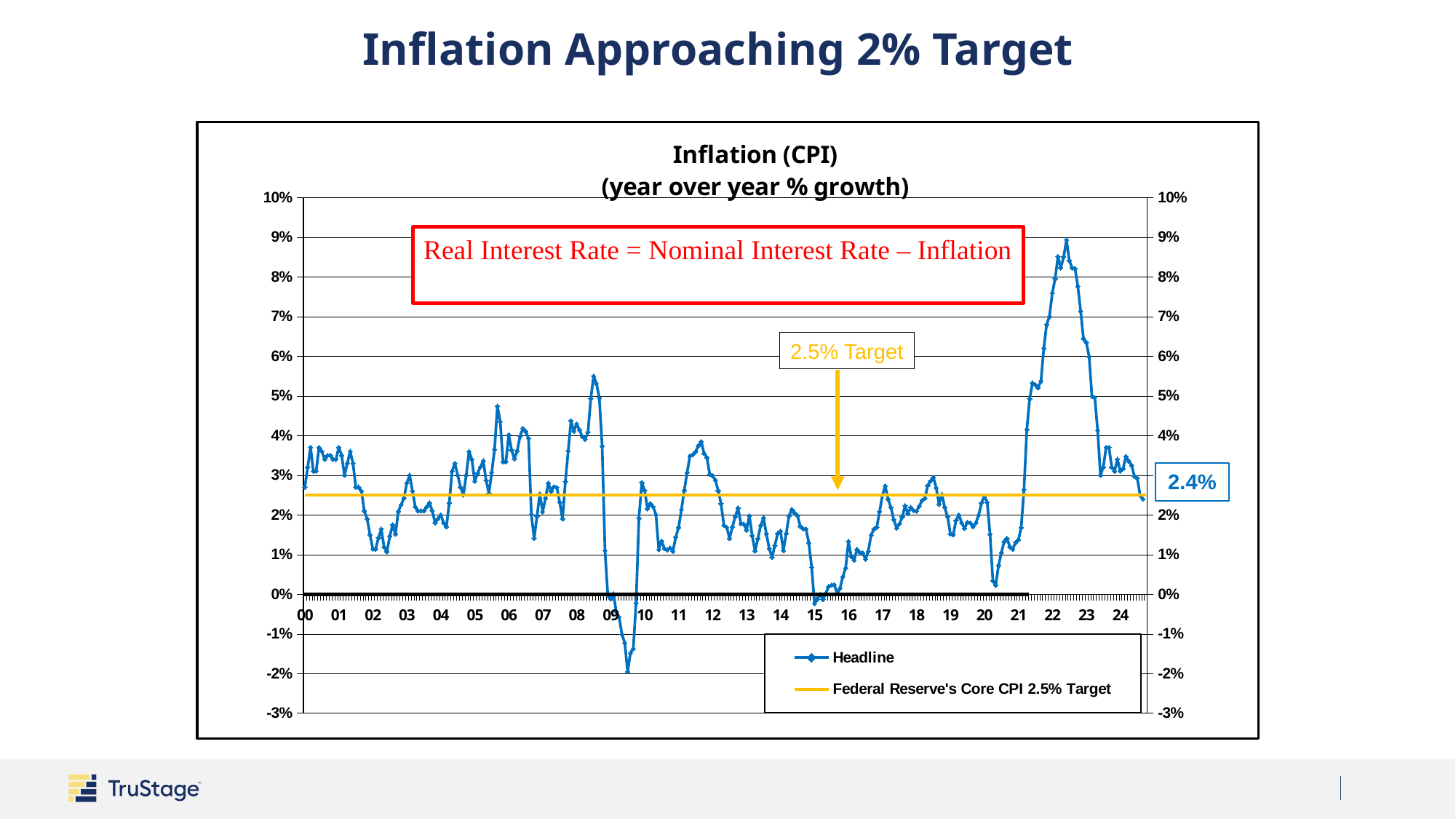
How many series does the chart legend list? 2 Which is larger, the latest Headline inflation value or the Federal Reserve's target? the Federal Reserve's target (2.5%) Is the lowest Headline inflation value around 2009 greater or less than -1%? less By how much is the latest Headline inflation value (2.4%) below the 2.5% target? 0.1% What kind of chart is shown on the slide? line chart Is the peak Headline inflation value around 2022 greater or less than 8%? greater In which year does the Headline inflation line reach its lowest point? 09 In which year does the Headline inflation line reach its highest point? 22 What is the title of the chart? Inflation (CPI) (year over year % growth) What value does the Federal Reserve's Core CPI target line sit at? 2.5% What is the most recent Headline inflation value labeled on the chart? 2.4% Does the Headline inflation line rise or fall from 2022 to 2024? fall